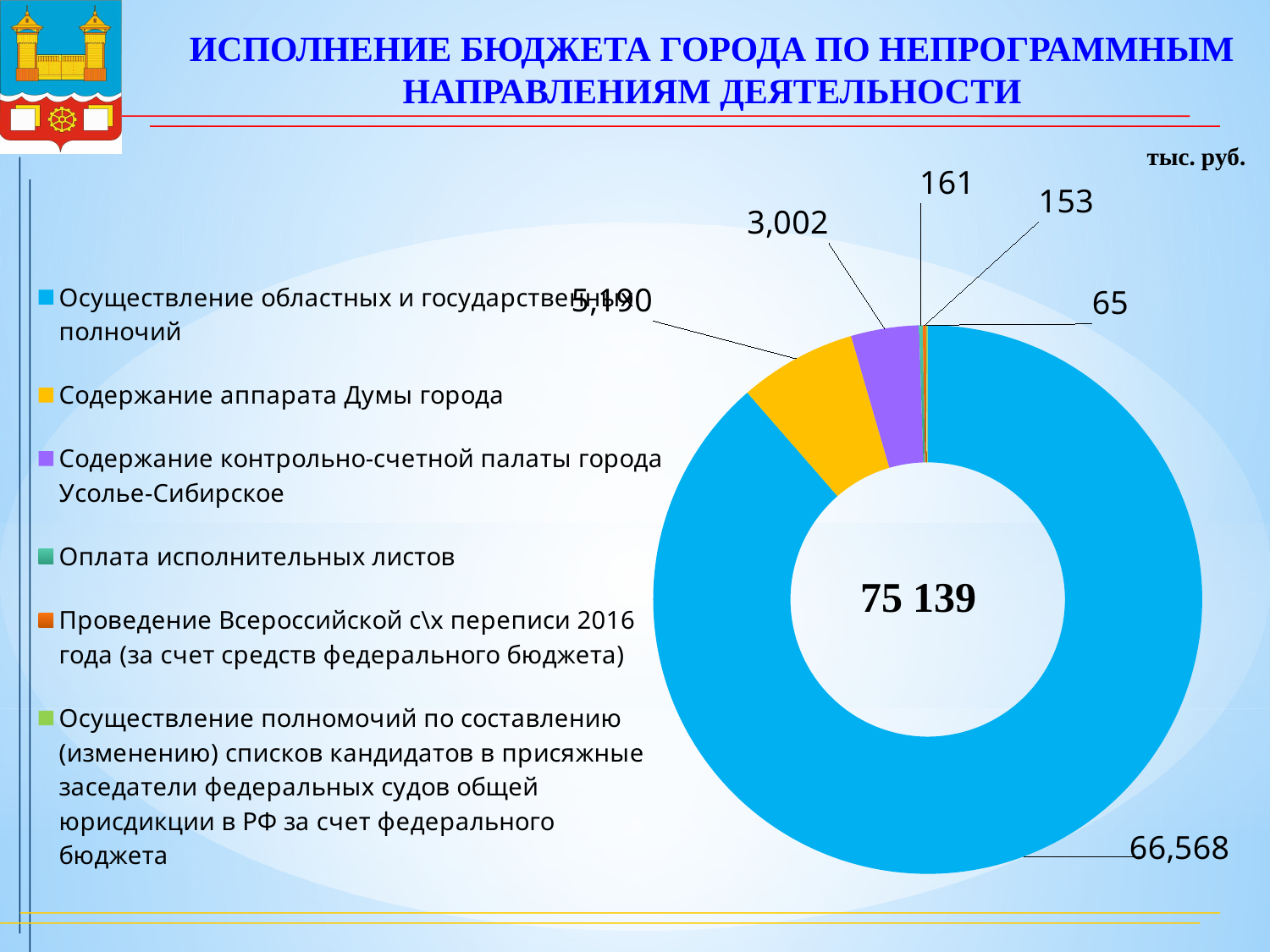
Which category has the smallest value in the chart? Осуществление полномочий по составлению (изменению) списков кандидатов в присяжные заседатели What number is printed in the centre of the doughnut chart? 75 139 What is the value for "Осуществление областных и государственных полномочий"? 66,568 What kind of chart is shown on the slide? Doughnut (pie) chart How many categories does the legend list? 6 What is the difference between the value for "Осуществление областных и государственных полномочий" and the value for "Содержание контрольно-счетной палаты города Усолье-Сибирское"? 63,566 Which is larger: the value for "Содержание контрольно-счетной палаты города Усолье-Сибирское" or the value for "Оплата исполнительных листов"? Содержание контрольно-счетной палаты города Усолье-Сибирское What is the value for "Осуществление полномочий по составлению (изменению) списков кандидатов в присяжные заседатели..."? 65 What is the value for "Проведение Всероссийской с\х переписи 2016 года (за счет средств федерального бюджета)"? 153 What is the value for "Содержание контрольно-счетной палаты города Усолье-Сибирское"? 3,002 Which category has the largest slice of the chart? Осуществление областных и государственных полномочий What is the value for "Оплата исполнительных листов"? 161